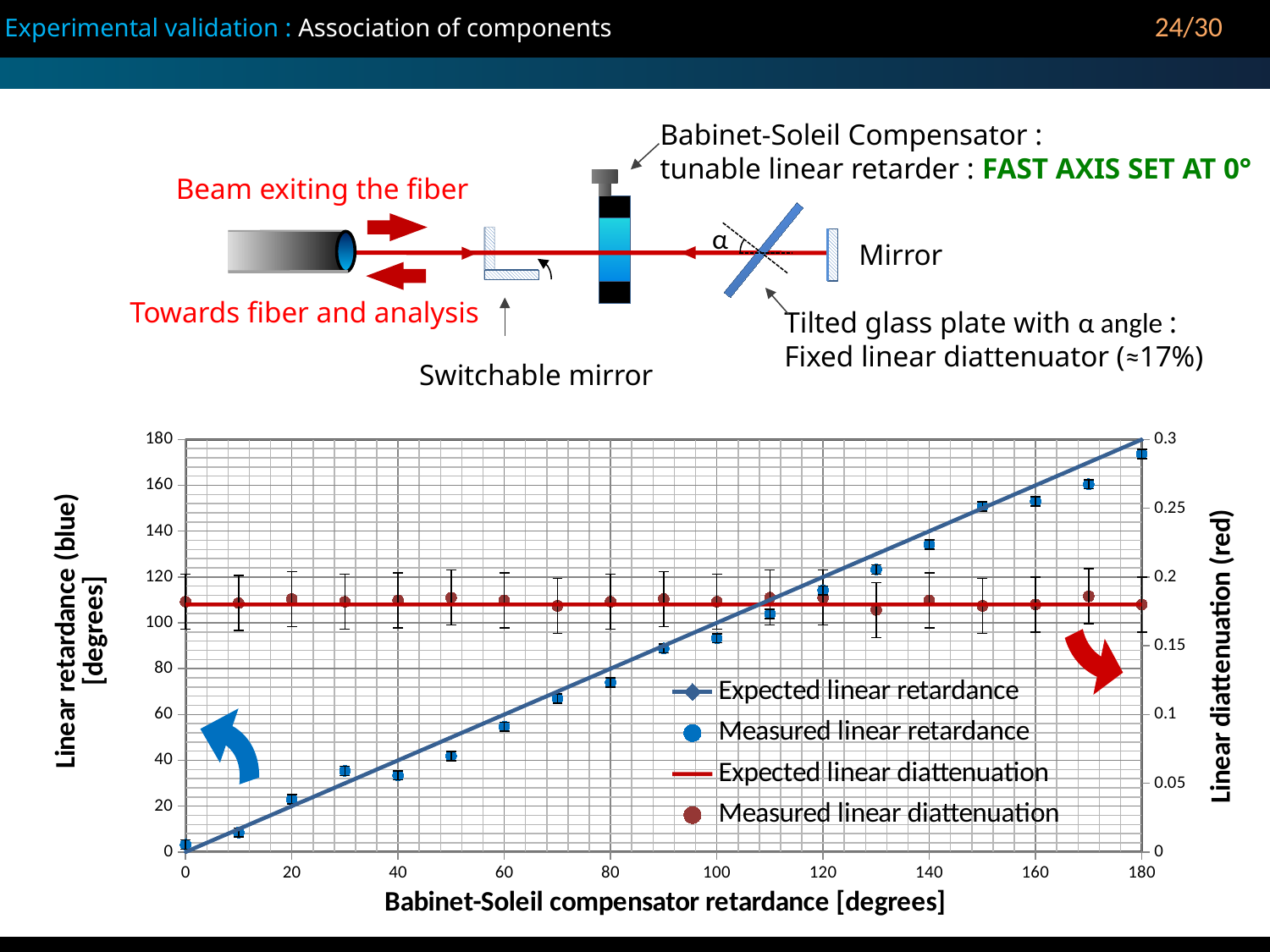
How many series does the chart legend list? 4 Is the measured linear retardance at a compensator retardance of 180 degrees greater or less than 160? greater Which is larger: the measured linear retardance at a compensator retardance of 180 degrees or at 160 degrees? 180 degrees Is the measured linear diattenuation at a compensator retardance of 100 degrees greater or less than 0.15? greater Is the expected linear diattenuation (red line) greater or less than 0.2 on the right-hand axis? less What kind of chart is shown on the slide? scatter chart At which x-axis value is the measured linear retardance highest? 180 At which x-axis value is the measured linear retardance lowest? 0 What is the title of the x axis of the chart? Babinet-Soleil compensator retardance [degrees] What is the title of the right-hand y axis of the chart? Linear diattenuation (red) Does the measured linear retardance rise or fall as the Babinet-Soleil compensator retardance increases along the x axis? rise